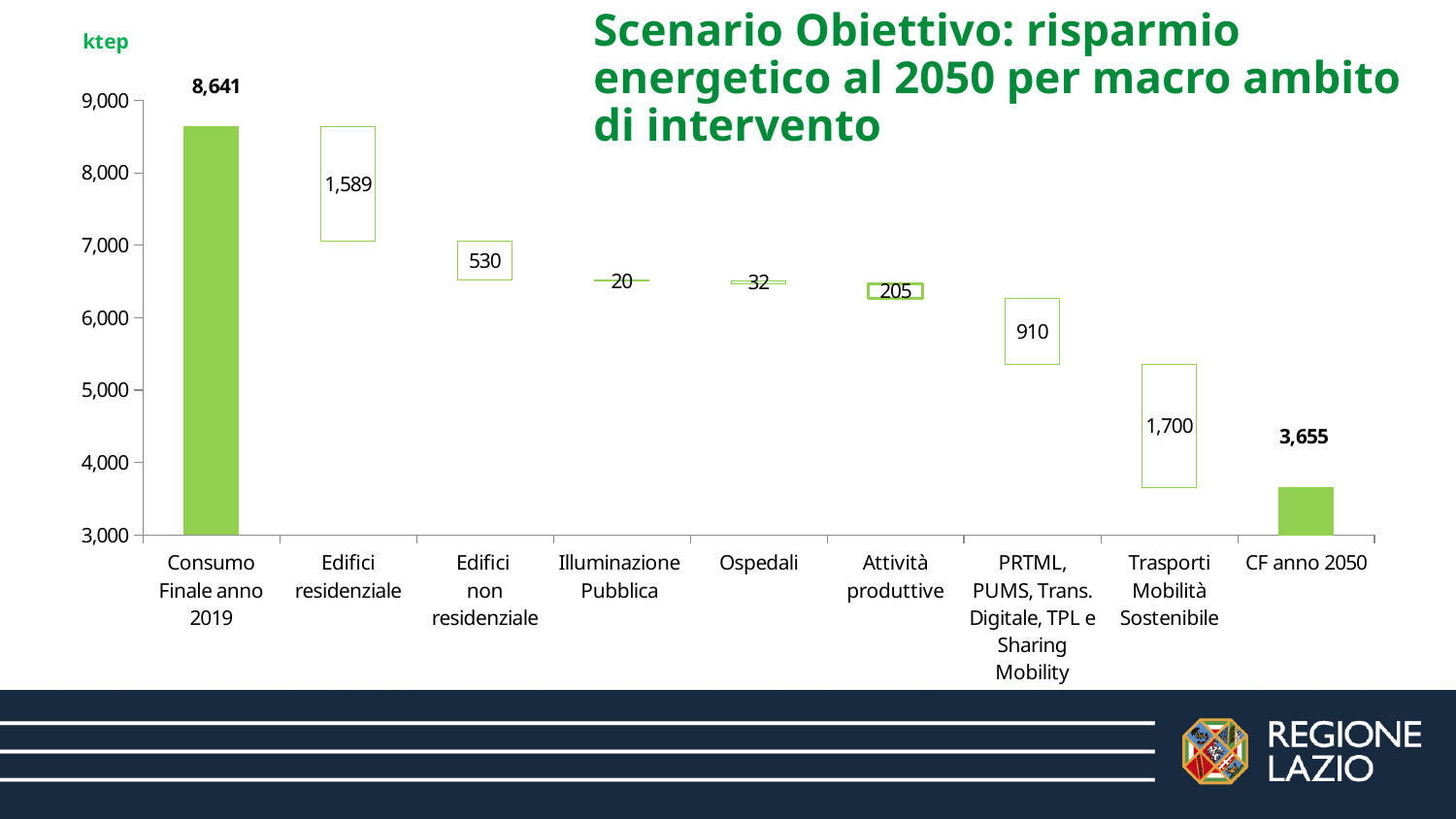
What is the value for Consumo Finale anno 2019? 8,641 Which category has the largest value shown? Consumo Finale anno 2019 What is the title of the chart? Scenario Obiettivo: risparmio energetico al 2050 per macro ambito di intervento Which category has the smallest value shown? Illuminazione Pubblica What unit is indicated at the top of the y axis? ktep What is the difference between Consumo Finale anno 2019 and CF anno 2050? 4,986 What is the value shown for Edifici residenziale? 1,589 Which is larger, the value for Edifici non residenziale or the value for PRTML, PUMS, Trans. Digitale, TPL e Sharing Mobility? PRTML, PUMS, Trans. Digitale, TPL e Sharing Mobility How many categories are shown on the x axis? 9 What is the value shown for Illuminazione Pubblica? 20 What is the value shown for Trasporti Mobilità Sostenibile? 1,700 What is the value for CF anno 2050? 3,655